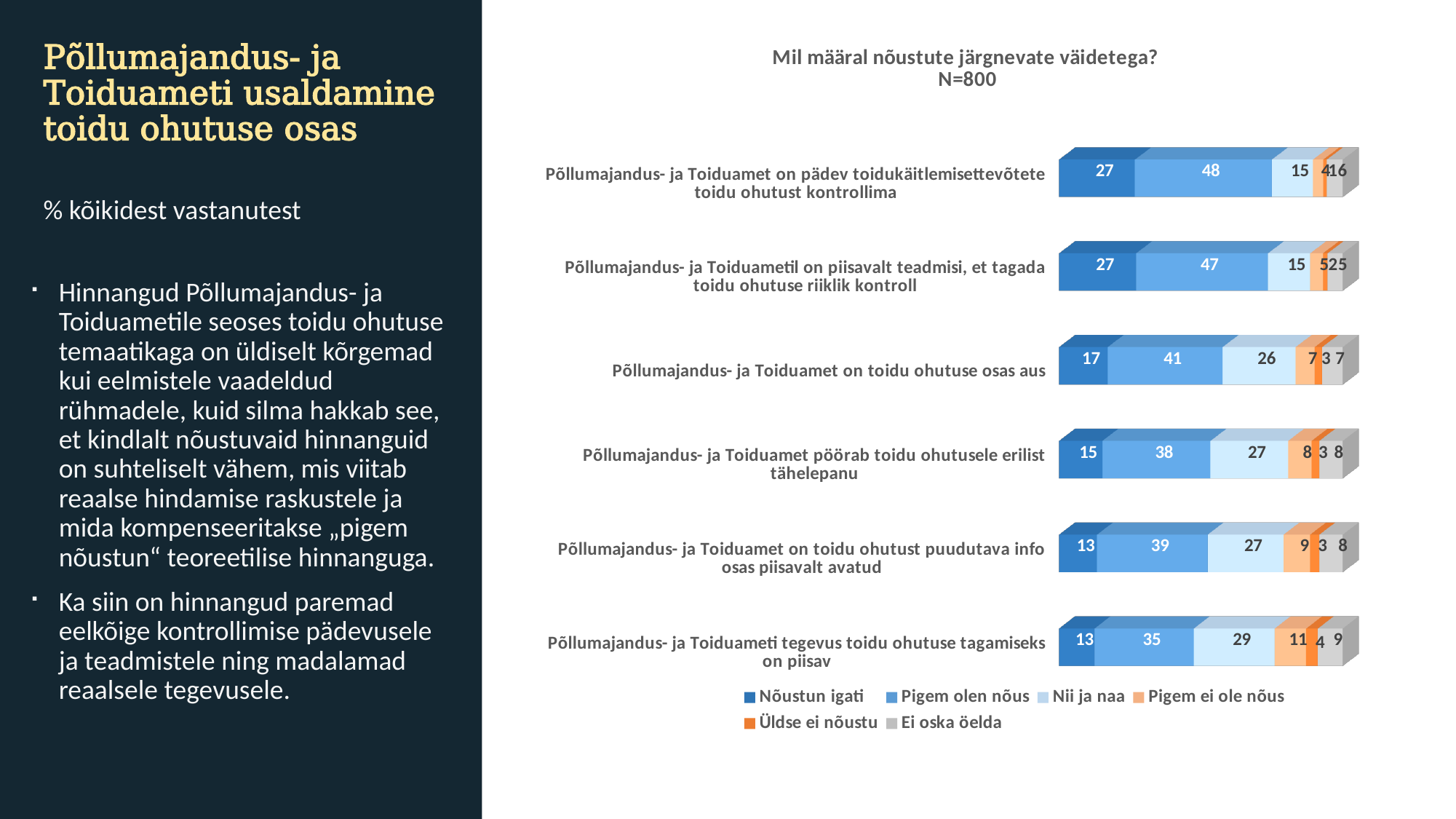
What type of chart is shown on the slide? Stacked bar chart Which is larger: the "Nõustun igati" value for "Põllumajandus- ja Toiduamet on toidu ohutuse osas aus" or for "Põllumajandus- ja Toiduamet pöörab toidu ohutusele erilist tähelepanu"? Põllumajandus- ja Toiduamet on toidu ohutuse osas aus Which statement has the highest "Pigem olen nõus" value? Põllumajandus- ja Toiduamet on pädev toidukäitlemisettevõtete toidu ohutust kontrollima What is the difference between the "Pigem olen nõus" values for "Põllumajandus- ja Toiduamet on pädev toidukäitlemisettevõtete toidu ohutust kontrollima" (48) and "Põllumajandus- ja Toiduameti tegevus toidu ohutuse tagamiseks on piisav" (35)? 13 What percentage of respondents answered "Nõustun igati" to the statement "Põllumajandus- ja Toiduamet on toidu ohutuse osas aus"? 17 What is the "Pigem olen nõus" value for the statement "Põllumajandus- ja Toiduamet on pädev toidukäitlemisettevõtete toidu ohutust kontrollima"? 48 What is the title of the chart? Mil määral nõustute järgnevate väidetega? N=800 How many series does the legend list? 6 What is the "Pigem ei ole nõus" value for the statement "Põllumajandus- ja Toiduamet on toidu ohutust puudutava info osas piisavalt avatud"? 9 How many statements are shown in the chart? 6 What is the "Nii ja naa" value for the statement "Põllumajandus- ja Toiduameti tegevus toidu ohutuse tagamiseks on piisav"? 29 Which statement has the highest "Nii ja naa" value? Põllumajandus- ja Toiduameti tegevus toidu ohutuse tagamiseks on piisav